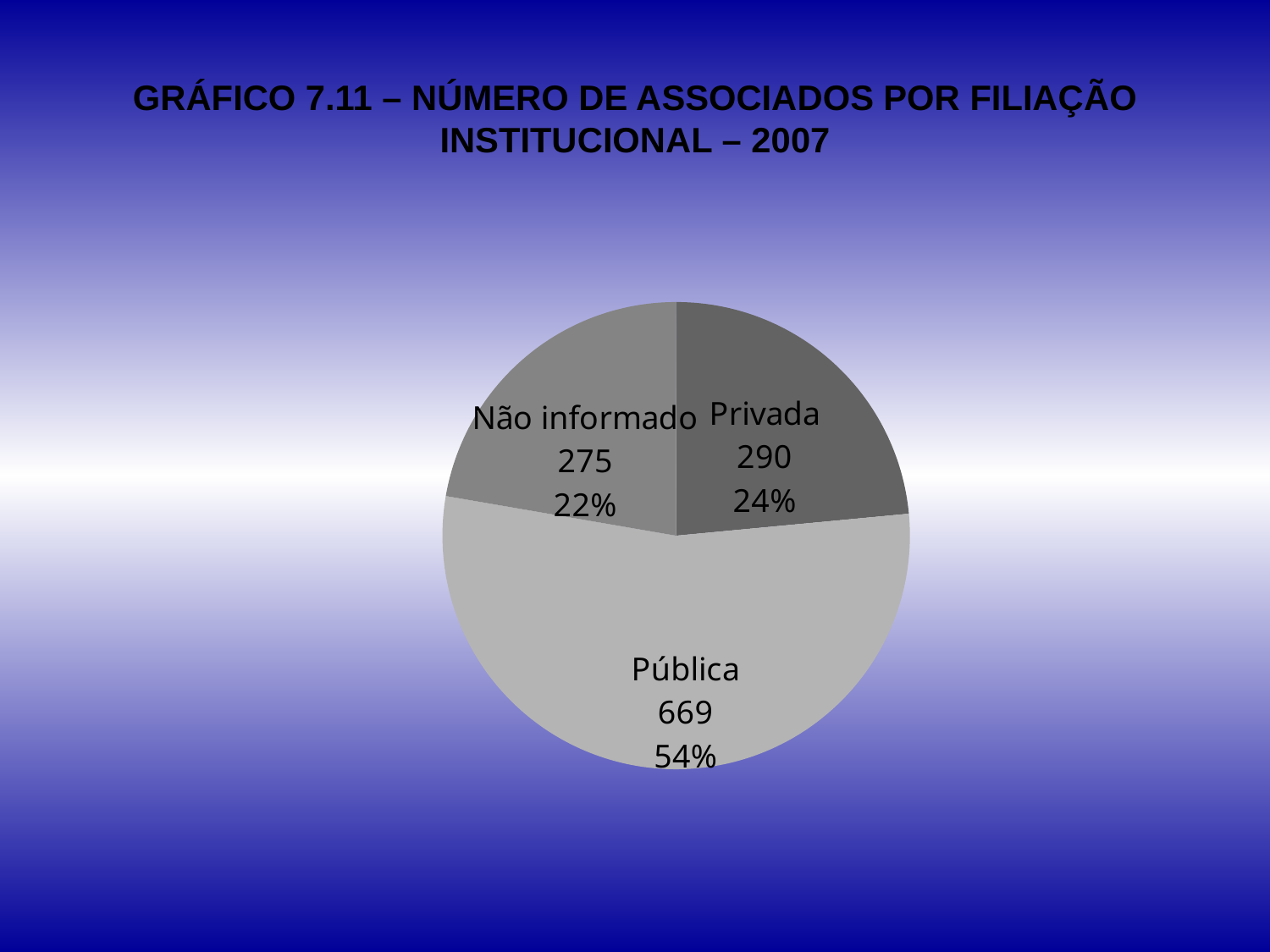
What is the number of associates for Privada? 290 What is the title of the chart? GRÁFICO 7.11 – NÚMERO DE ASSOCIADOS POR FILIAÇÃO INSTITUCIONAL – 2007 What share of the pie does Pública represent? 54% What is the difference between the number of associates for Pública and Privada? 379 Which category has the smallest number of associates? Não informado What kind of chart is shown on the slide? pie chart Which category has the largest number of associates? Pública What is the number of associates for Pública? 669 What is the number of associates for Não informado? 275 What share of the pie does Não informado represent? 22% How many slices does the pie chart have? 3 What share of the pie does Privada represent? 24%